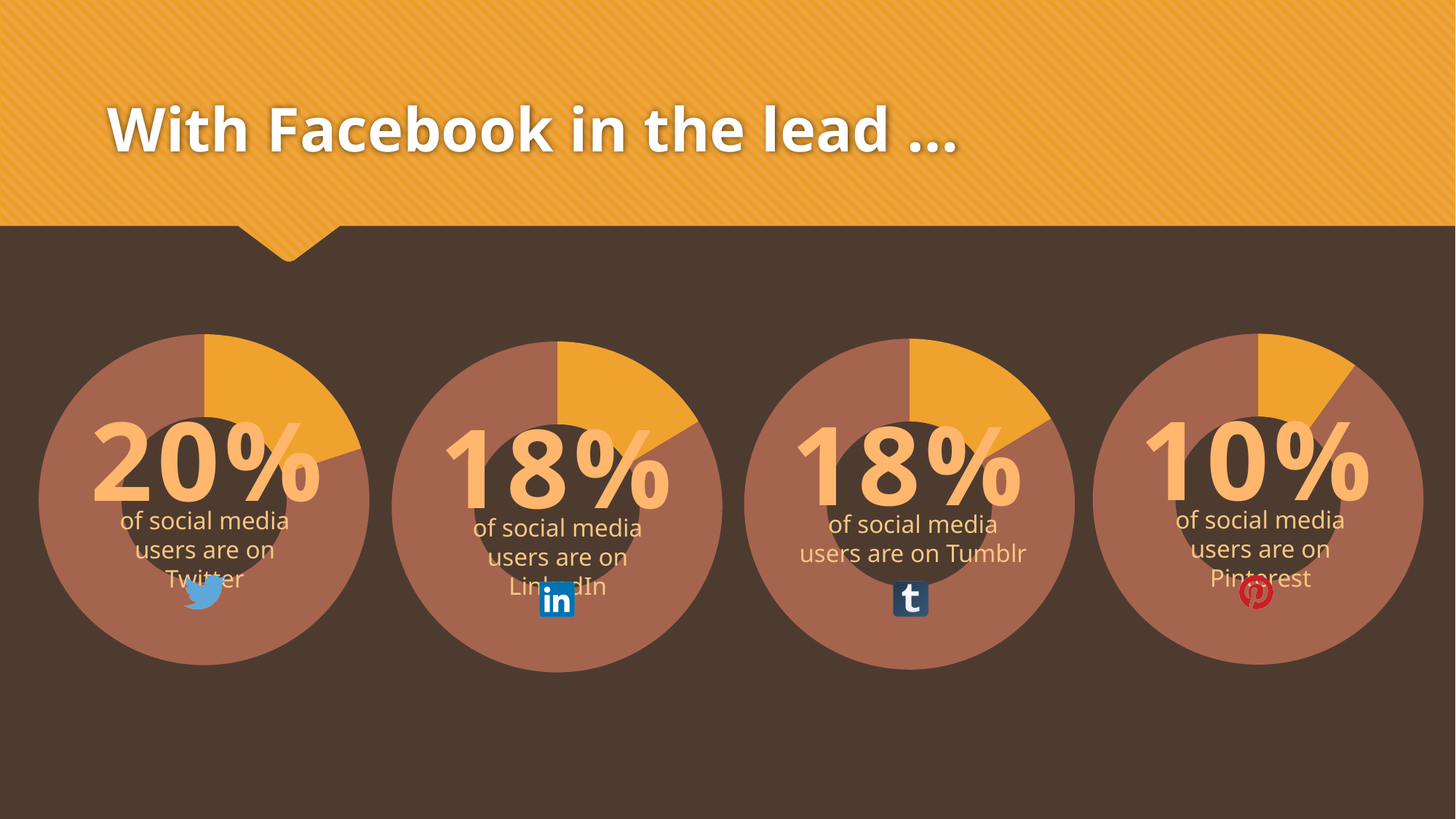
In the Pinterest donut chart, what percentage of social media users are on Pinterest? 10% Comparing the Twitter and LinkedIn donut charts, which platform has the larger share of social media users? Twitter In the Tumblr donut chart, what percentage of social media users are on Tumblr? 18% Across the four donut charts, which platform has the highest share of social media users? Twitter How many donut charts are shown on the slide? 4 Across the four donut charts, which platform has the lowest share of social media users? Pinterest What is the difference between the Twitter share and the LinkedIn share shown in the donut charts? 2% What is the title of the slide containing the four donut charts? With Facebook in the lead ... What is the difference between the Twitter share and the Pinterest share shown in the donut charts? 10% What kind of chart is used to show each platform's share of social media users? Donut (pie) chart In the Twitter donut chart, what percentage of social media users are on Twitter? 20% In the LinkedIn donut chart, what percentage of social media users are on LinkedIn? 18%